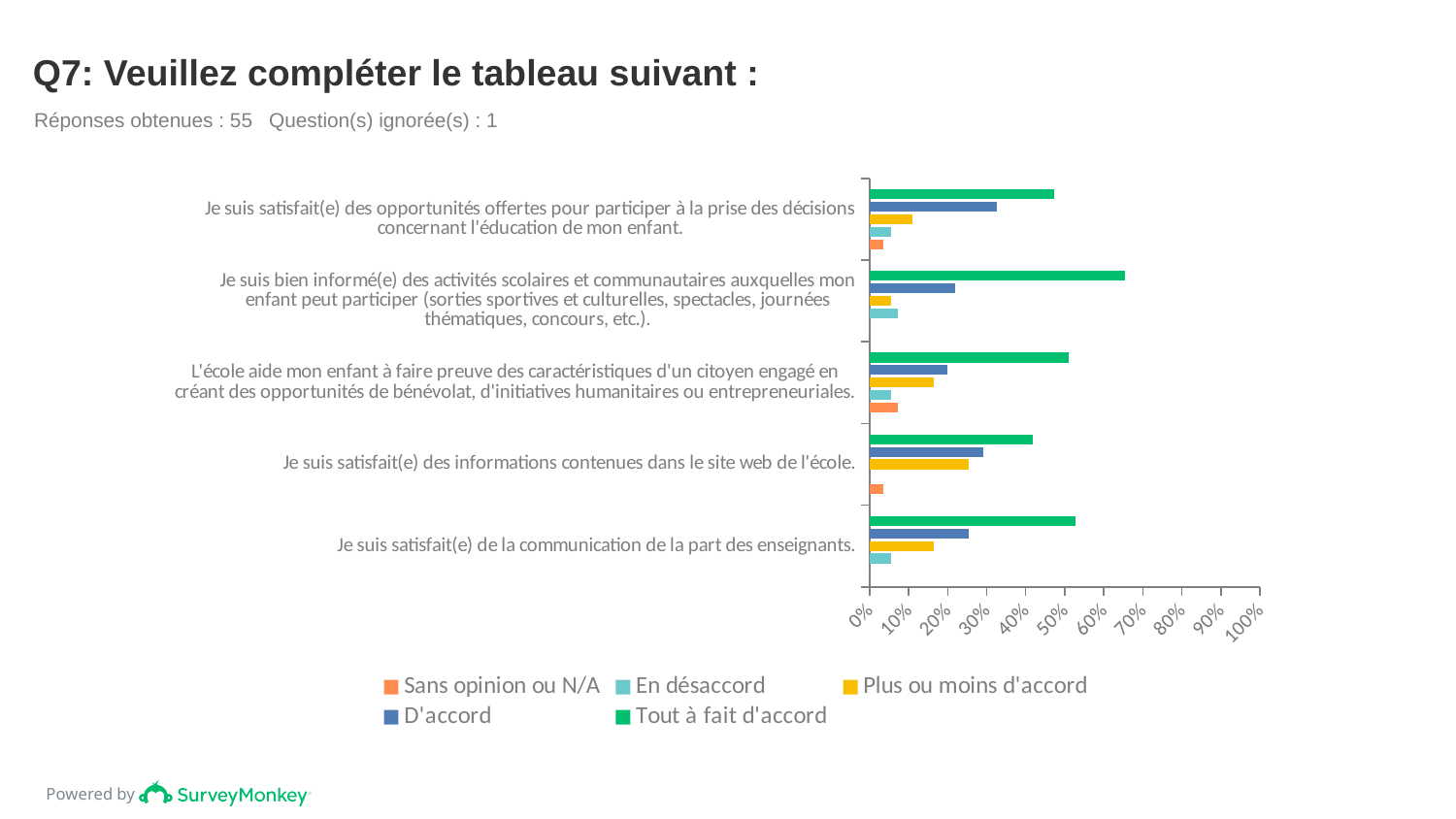
For 'Je suis satisfait(e) de la communication de la part des enseignants.', which is larger: 'Tout à fait d'accord' or 'D'accord'? Tout à fait d'accord What kind of chart is shown on the slide? Bar chart What colour represents 'Tout à fait d'accord' in the legend? Green Which statement has the highest value for 'Tout à fait d'accord'? Je suis bien informé(e) des activités scolaires et communautaires auxquelles mon enfant peut participer What is the maximum value shown on the percentage axis? 100% Is the 'Tout à fait d'accord' value for 'Je suis satisfait(e) des informations contenues dans le site web de l'école.' greater or less than 50%? less Is the 'Plus ou moins d'accord' value for 'Je suis satisfait(e) des informations contenues dans le site web de l'école.' greater or less than 20%? greater Which statement has the lowest value for 'Tout à fait d'accord'? Je suis satisfait(e) des informations contenues dans le site web de l'école. How many series does the legend list? 5 Is the 'Tout à fait d'accord' value for 'Je suis bien informé(e) des activités scolaires et communautaires...' greater or less than 60%? greater How many statements (categories) are plotted on the chart? 5